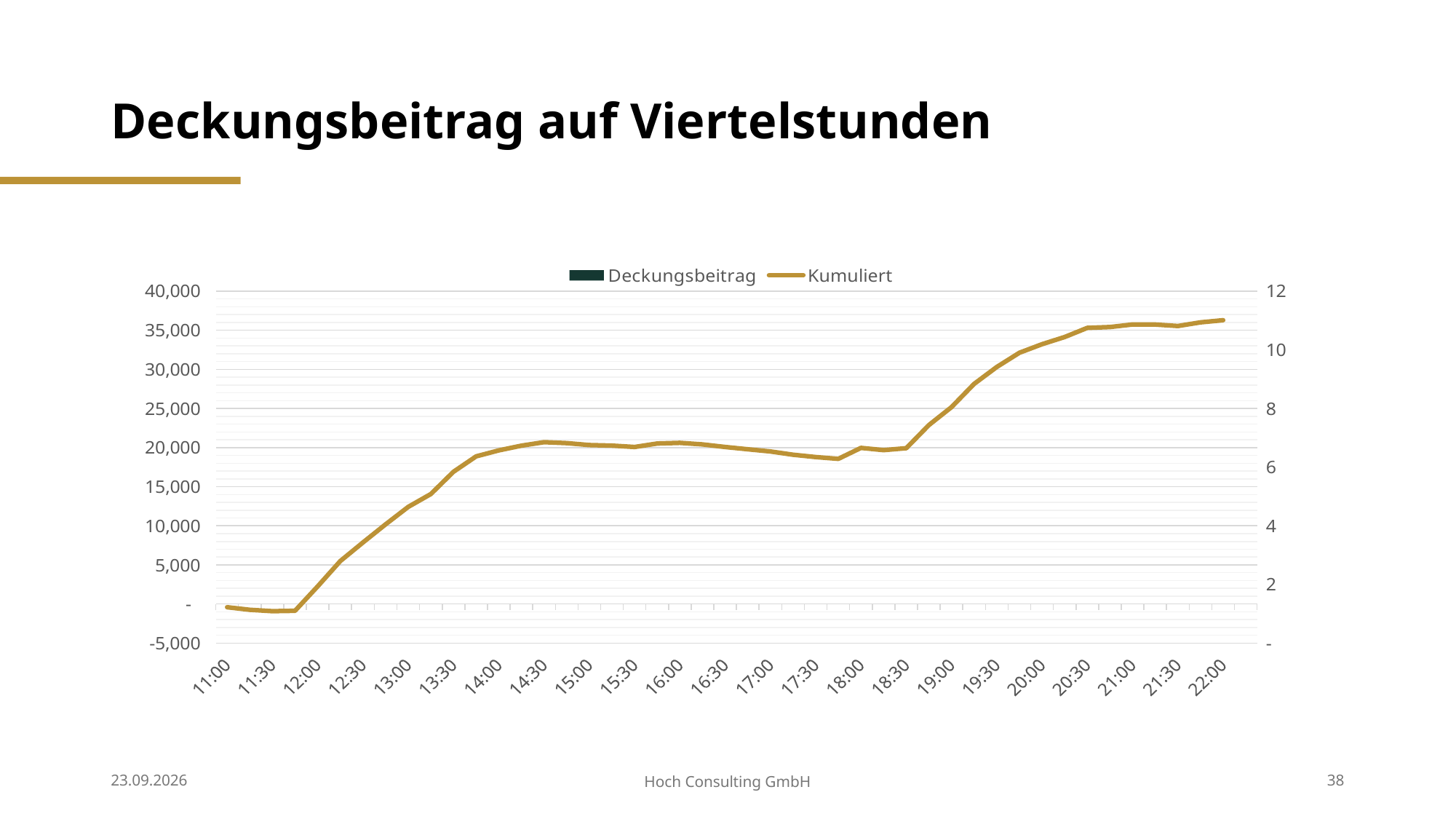
Which series is drawn as a line in the chart? Kumuliert Between 14:30 and 17:30, does the Kumuliert line rise, fall, or stay roughly flat? stay roughly flat Does the Kumuliert line overall rise or fall from 11:00 to 22:00? rise How many series does the chart legend list? 2 What is the highest value shown on the right vertical axis? 12 What is the title of the chart on the slide? Deckungsbeitrag auf Viertelstunden Is the Kumuliert value at 17:00 larger or smaller than at 13:00? larger At which time label does the Kumuliert line reach its highest point? 22:00 How many time labels are shown on the x axis? 23 What are the names of the two series in the legend? Deckungsbeitrag and Kumuliert Is the Kumuliert value at 20:00 larger or smaller than at 14:30? larger